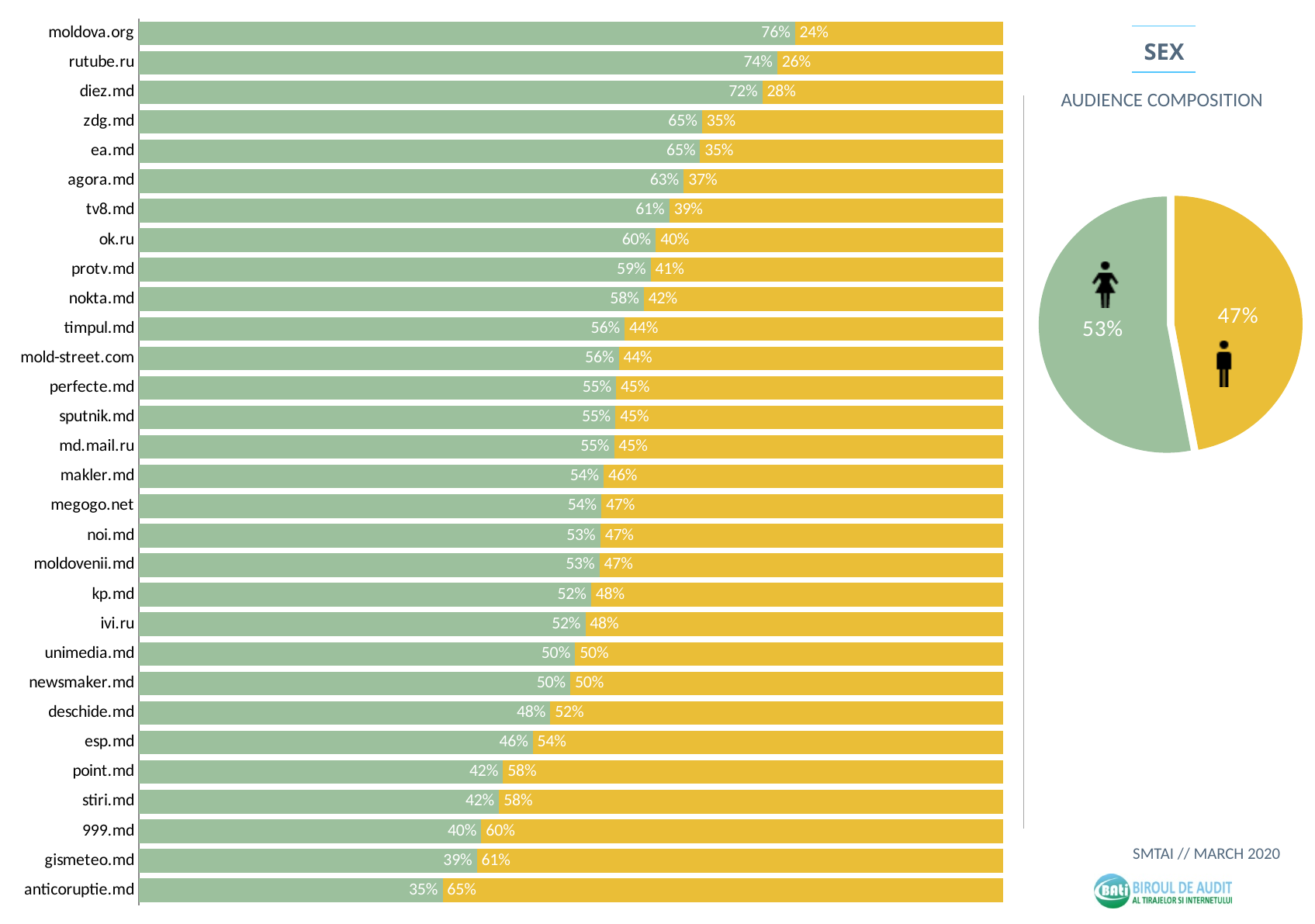
What kind of chart is the large chart on the left of the slide? Bar chart In the pie chart on the right, what share is shown for the slice with the female icon? 53% In the pie chart on the right, what value is shown for the yellow slice with the male icon? 47% In the bar chart, which site has a larger green segment, diez.md or zdg.md? diez.md What is the title shown above the pie chart on the right? SEX AUDIENCE COMPOSITION In the bar chart, which site has the largest green segment? moldova.org In the bar chart, what is the value of the yellow segment for anticoruptie.md? 65% In the bar chart, what is the value of the yellow segment for ok.ru? 40% In the bar chart, what is the difference between the green and yellow segments for moldova.org? 52 percentage points In the bar chart, what is the value of the green segment for moldova.org? 76% How many sites are listed in the bar chart? 30 In the bar chart, which site has the smallest green segment? anticoruptie.md